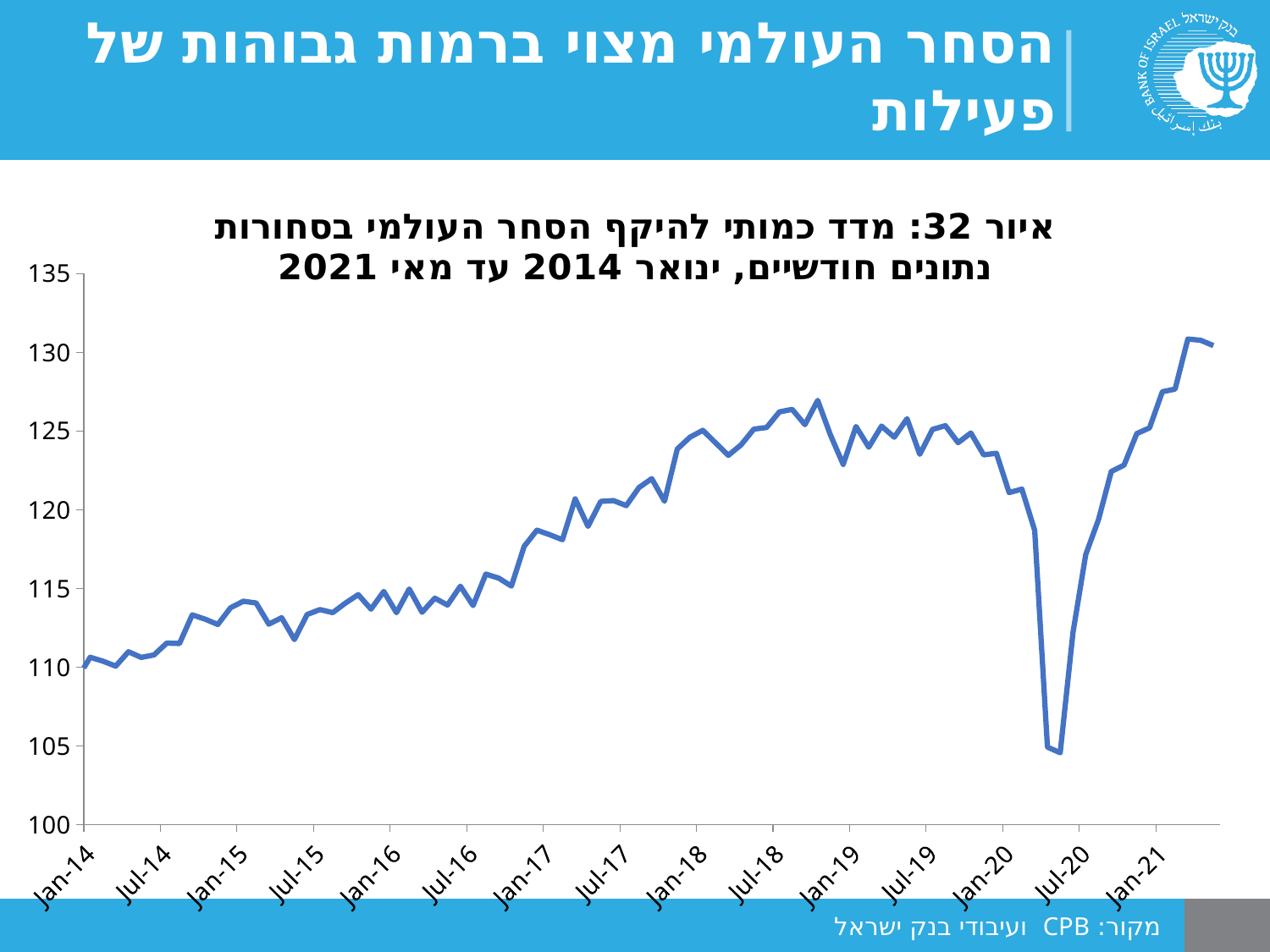
Which is larger, the value at Jan-19 or the value at Jan-14? Jan-19 What is the source cited at the bottom of the slide? CPB ועיבודי בנק ישראל Is the value for Jan-20 greater or less than 125? less Which is larger, the value at Jan-21 or the value at Jul-20? Jan-21 Does the line generally rise or fall from Jan-14 to Jan-19? rise Around which x-axis label does the line reach its lowest point? Jul-20 Is the highest point of the line, in 2021, greater or less than 130? greater Is the lowest point of the line, in 2020, greater or less than 110? less How many date labels are shown on the x axis? 15 What kind of chart is shown on the slide? line chart